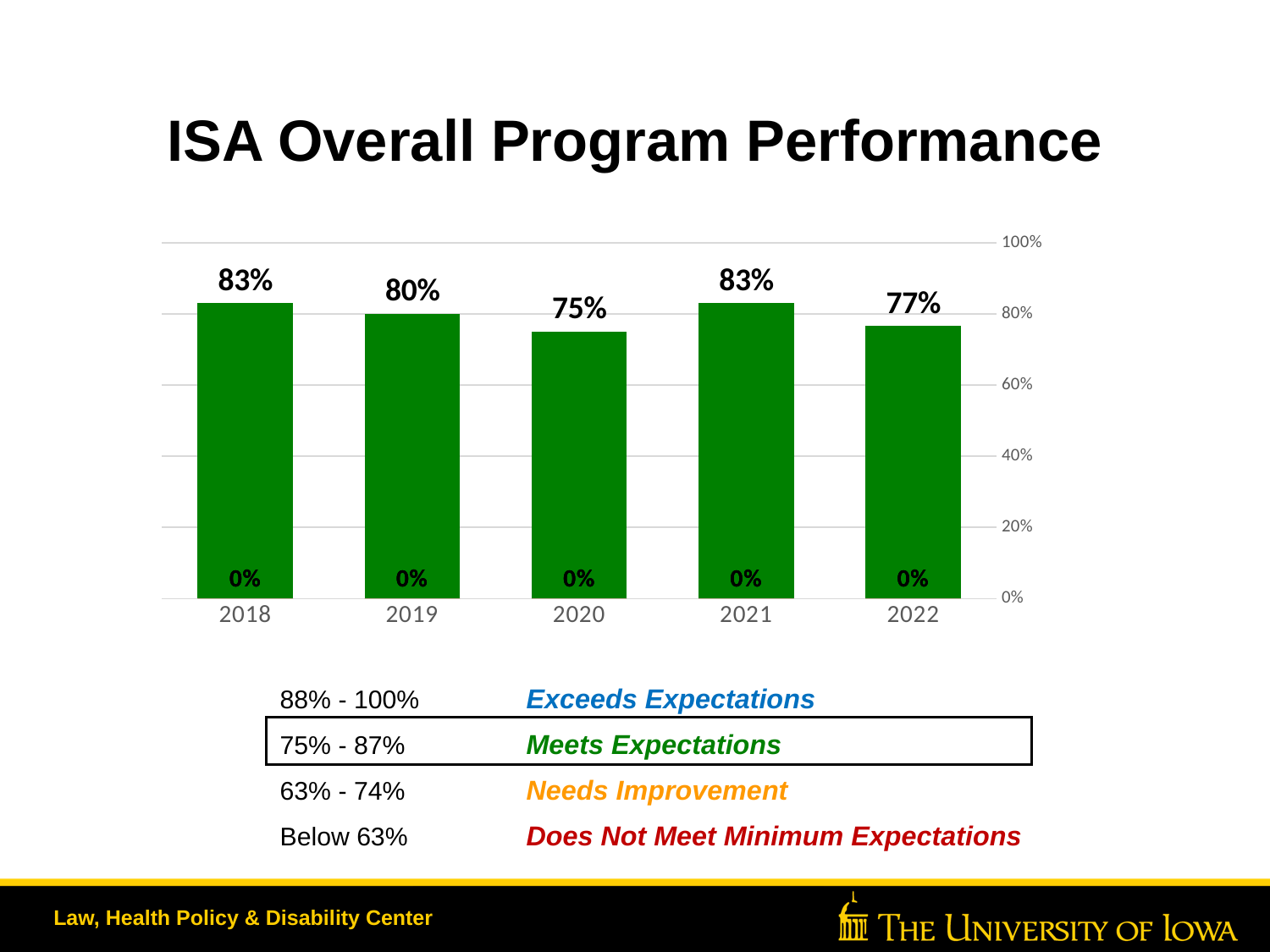
What is the value for 2020? 75% What is the value for 2018? 83% What is the difference between the values for 2021 and 2022? 6% Which years share the highest value? 2018 and 2021 How many years are shown on the x axis? 5 Is the value for 2022 greater or less than 80%? less What is the title of the slide? ISA Overall Program Performance What is the value for 2019? 80% What is the value for 2022? 77% What kind of chart is shown on the slide? bar chart Which year has the lowest value? 2020 Which is larger, the value for 2019 or the value for 2020? 2019